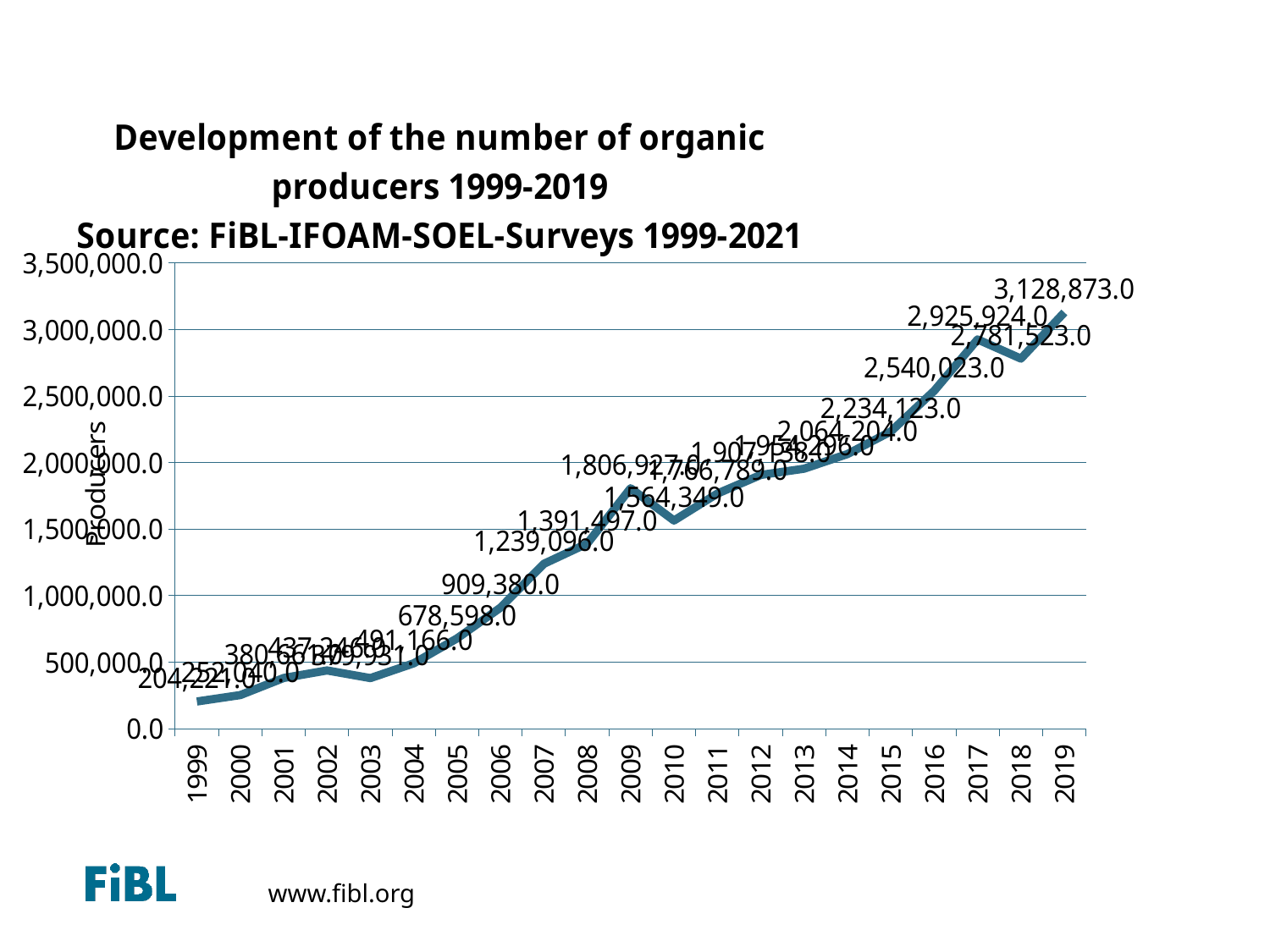
What kind of chart is shown on the slide? line chart Is the number of organic producers in 2003 greater or less than 500,000.0? less Which year has the lowest number of organic producers? 1999 What is the number of organic producers in 2010? 1,564,349.0 What is the difference between the number of producers in 2019 and in 2018? 347,350.0 What is the number of organic producers in 2019? 3,128,873.0 What is the number of organic producers in 2016? 2,540,023.0 What is the number of organic producers in 2017? 2,925,924.0 What is the number of organic producers in 2018? 2,781,523.0 Which year has more organic producers, 2017 or 2018? 2017 Which year has the highest number of organic producers? 2019 What is the number of organic producers in 2006? 909,380.0